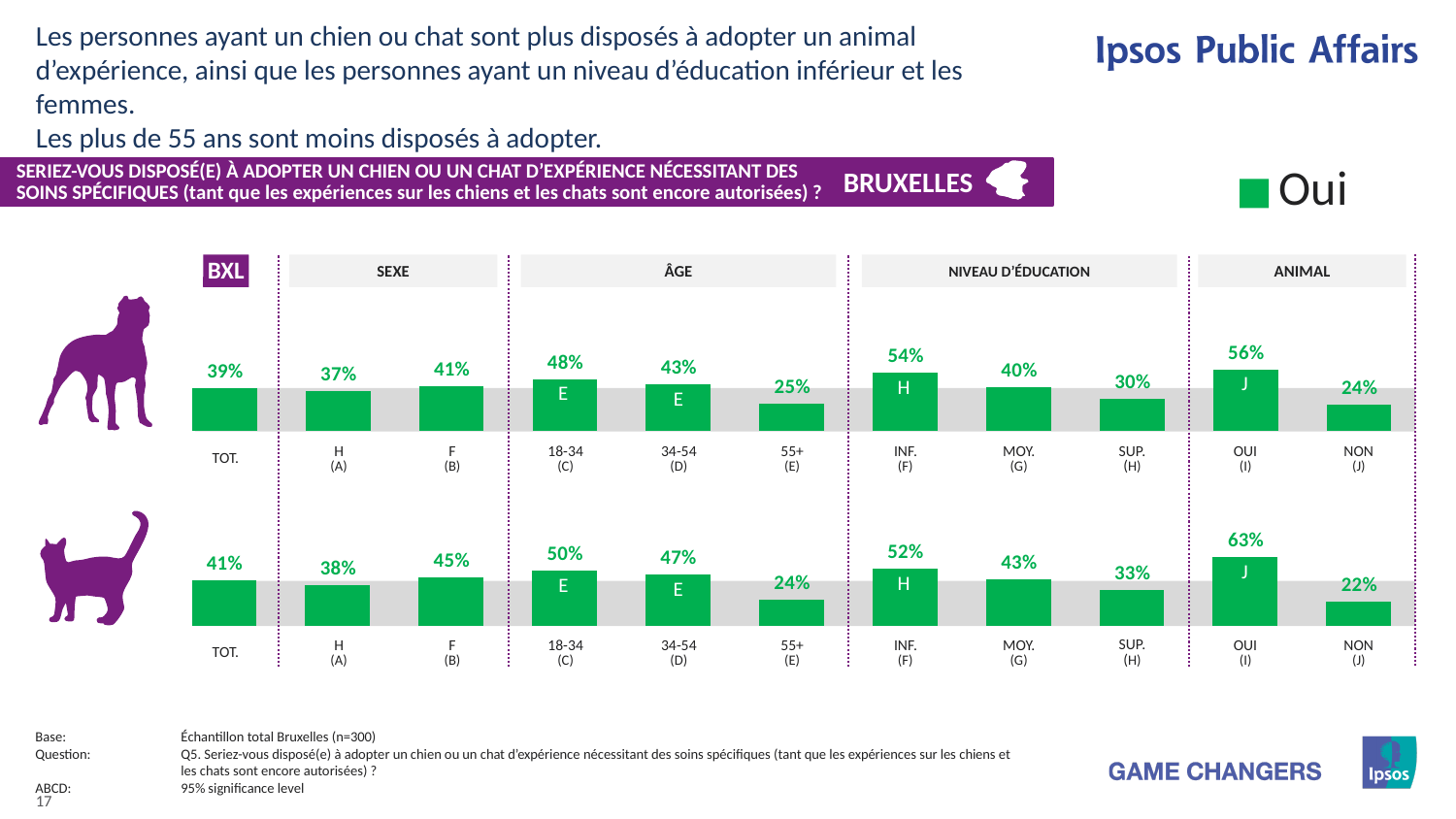
In the bottom (cat) chart, what is the difference between the values for 18-34 (C) and 55+ (E)? 26% In the top (dog) chart, what is the difference between the values for F (B) and H (A)? 4% How many categories (bars) are shown in the bottom (cat) chart? 11 In the bottom (cat) chart, what is the value for SUP. (H)? 33% In the top (dog) chart, which is larger, the value for INF. (F) or the value for MOY. (G)? INF. (F) In the bottom (cat) chart, what is the value for OUI (I) under ANIMAL? 63% In the top (dog) chart, what is the value for TOT.? 39% In the top (dog) chart, what is the value for 55+ (E)? 25% In the top (dog) chart, which category has the highest value? OUI (I) What kind of chart is used on this slide? Bar chart How many series does the legend list? 1 In the bottom (cat) chart, which category has the lowest value? NON (J)